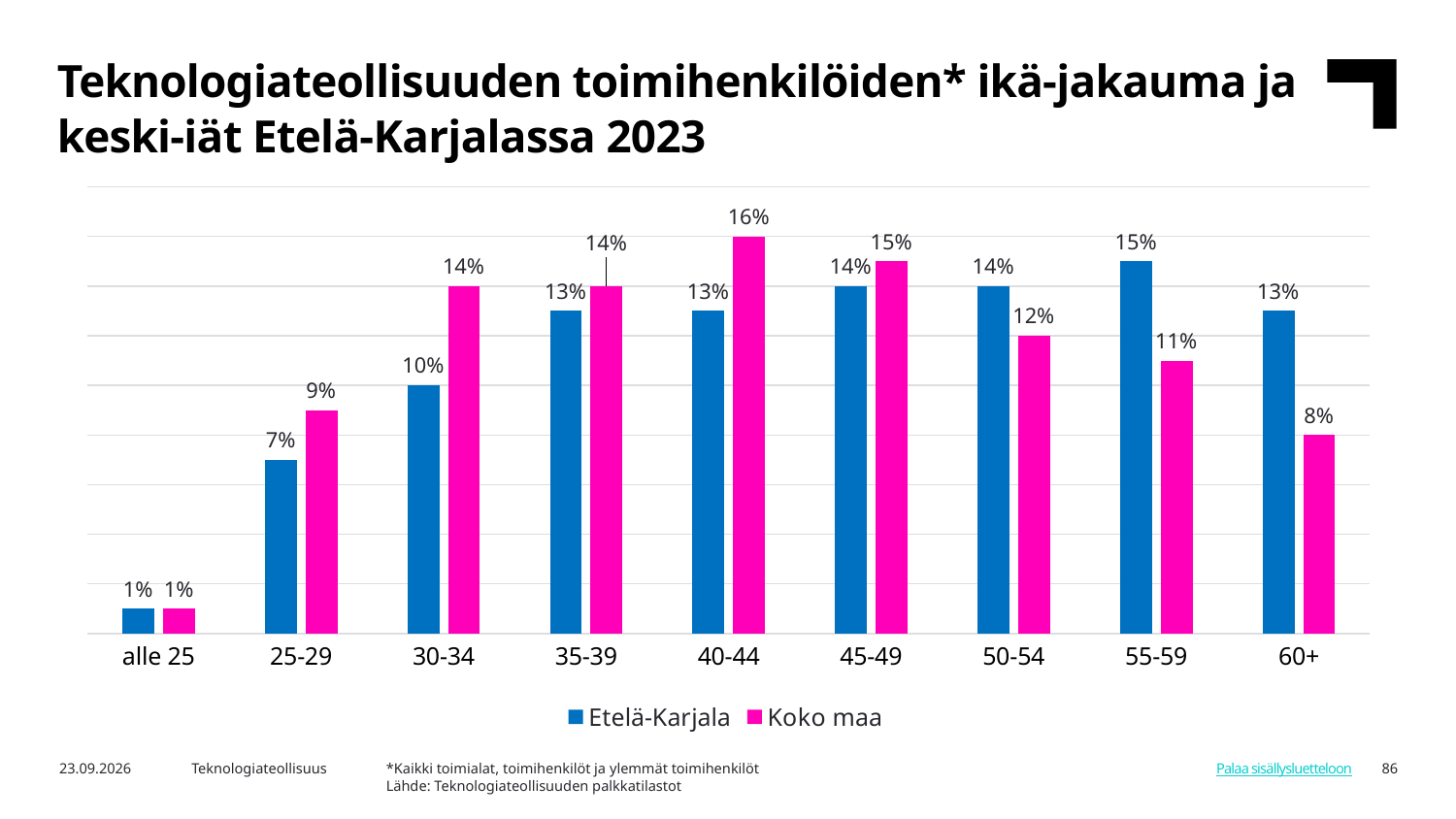
How many series does the legend list? 2 What is the value for Koko maa in the 55-59 age group? 11% Which age group has the highest value for Etelä-Karjala? 55-59 What is the difference between the Etelä-Karjala and Koko maa values in the 60+ age group? 5% Which age group has the lowest value for Etelä-Karjala? alle 25 Which age group has the highest value for Koko maa? 40-44 What is the value for Koko maa in the 60+ age group? 8% In the 50-54 age group, which series has the larger value, Etelä-Karjala or Koko maa? Etelä-Karjala What is the value for Etelä-Karjala in the 30-34 age group? 10% What is the difference between the Koko maa and Etelä-Karjala values in the 25-29 age group? 2% How many age groups are shown on the x axis? 9 What kind of chart is shown on the slide? Bar chart